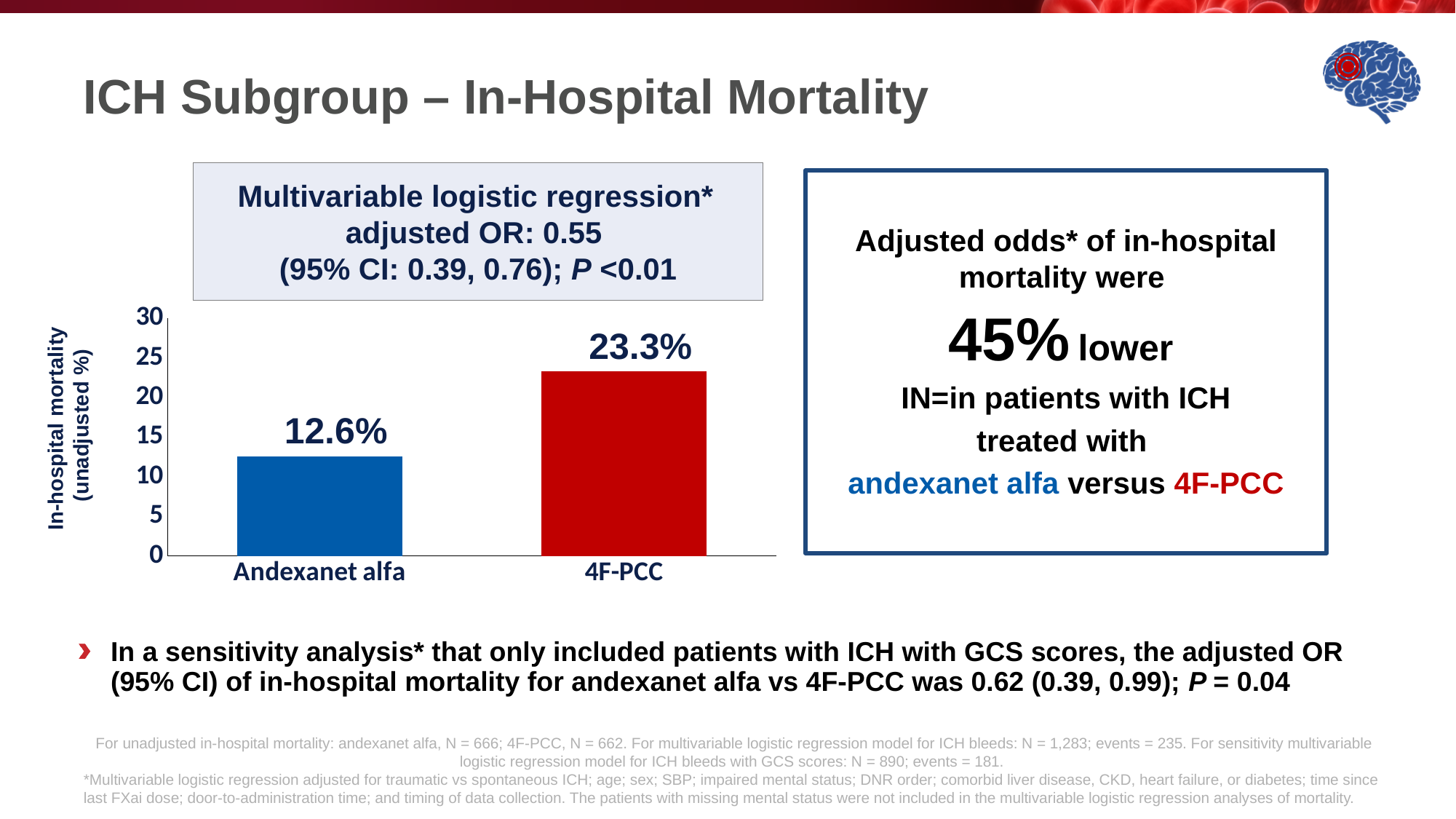
Is the value for 4F-PCC greater or less than 20? greater What is the difference in in-hospital mortality between 4F-PCC and Andexanet alfa? 10.7% What is the in-hospital mortality value for 4F-PCC? 23.3% What is the in-hospital mortality value for Andexanet alfa? 12.6% What kind of chart is shown on the slide? Bar chart How many categories are shown in the chart? 2 Is the value for Andexanet alfa greater or less than 15? less Which category has the lowest in-hospital mortality? Andexanet alfa What colour is the bar for 4F-PCC? Red Which category has the highest in-hospital mortality? 4F-PCC Which has a larger in-hospital mortality value, Andexanet alfa or 4F-PCC? 4F-PCC What is the label of the y axis of the chart? In-hospital mortality (unadjusted %)